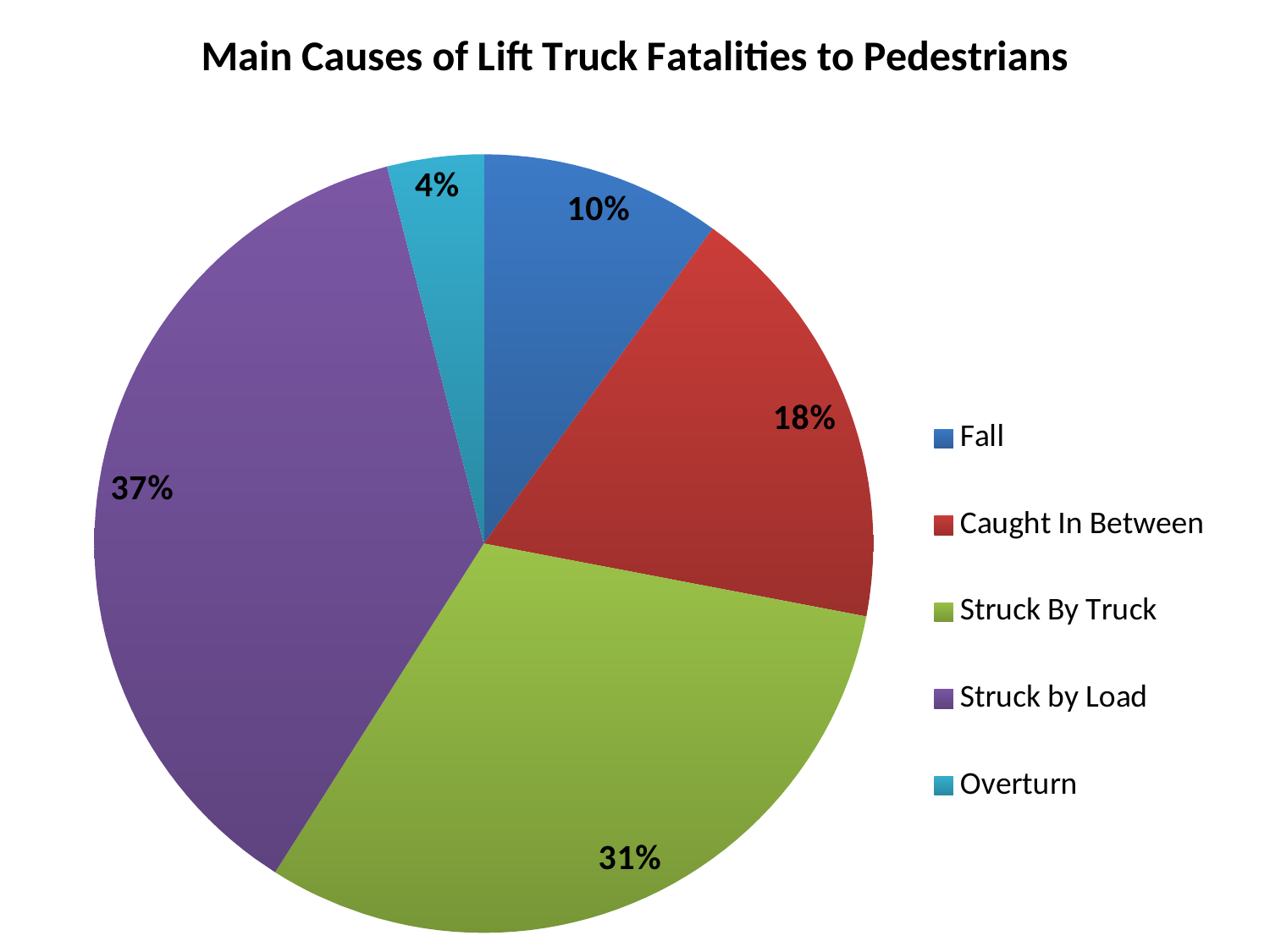
What percentage of lift truck fatalities to pedestrians is attributed to Struck by Load? 37% What percentage of the pie is Caught In Between? 18% What type of chart is shown on the slide? Pie chart What is the title of the chart? Main Causes of Lift Truck Fatalities to Pedestrians What share of the pie does Fall represent? 10% Which category is shown in green in the pie chart? Struck By Truck How many categories are shown in the pie chart? 5 Which cause accounts for the largest share of lift truck fatalities to pedestrians? Struck by Load Which cause accounts for the smallest share of the pie? Overturn What is the difference in percentage points between Caught In Between and Fall? 8 Which is larger, the share for Struck By Truck or the share for Caught In Between? Struck By Truck What is the difference in percentage points between Struck by Load and Struck By Truck? 6